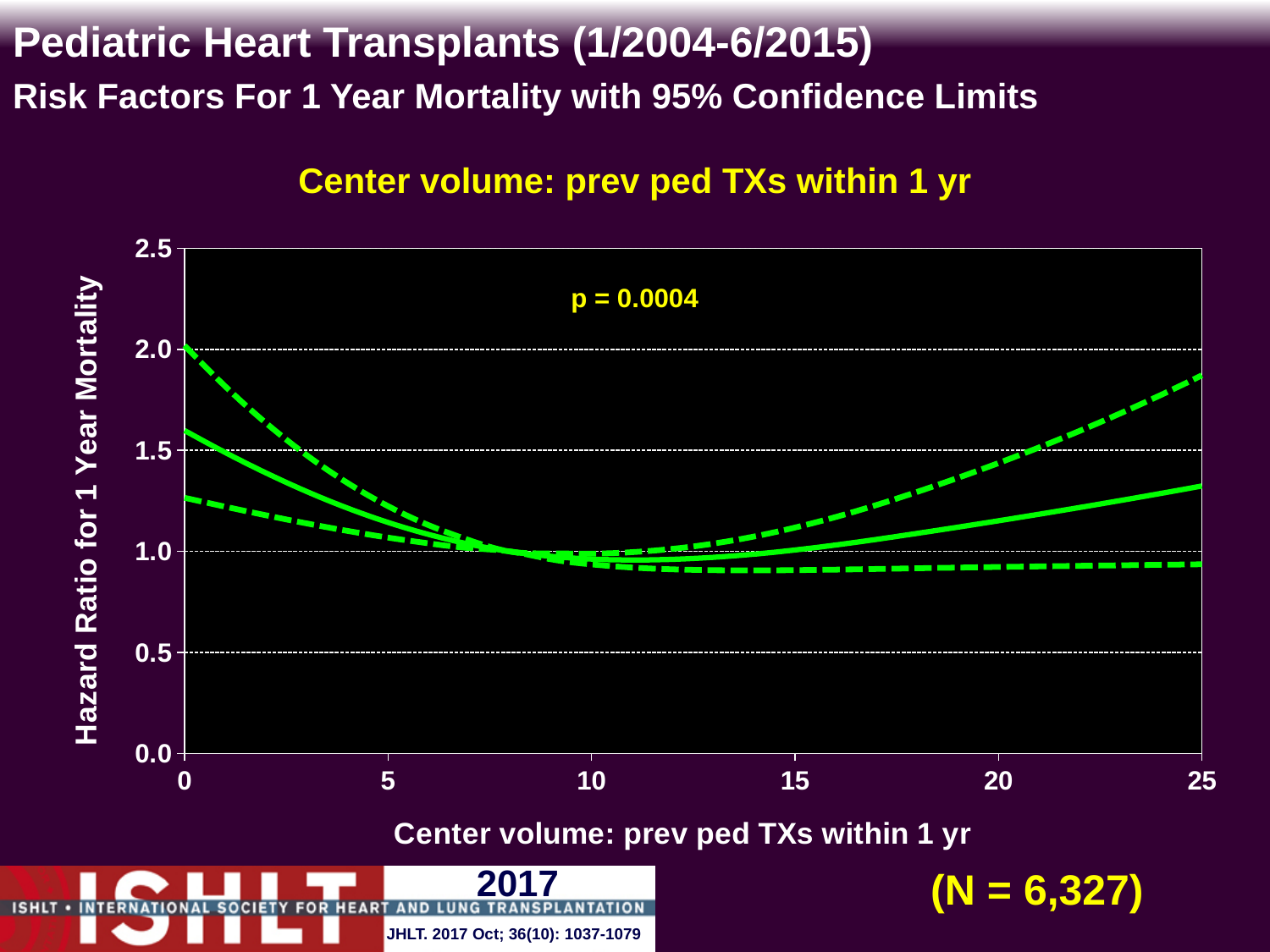
What kind of chart is shown on the slide? line chart What is the p-value printed on the chart? p = 0.0004 Is the hazard ratio (solid line) at a center volume of 0 greater or less than 1.5? greater Does the hazard ratio (solid line) rise or fall as center volume increases from 15 to 25? rise Is the hazard ratio (solid line) at a center volume of 25 greater or less than 1.0? greater How many lines are plotted on the chart? 3 Is the lower confidence limit (lower dashed line) at a center volume of 25 greater or less than 1.0? less Is the hazard ratio (solid line) at a center volume of 0 larger or smaller than at a center volume of 25? larger What is the sample size (N) shown on the slide? N = 6,327 Does the hazard ratio (solid line) rise or fall as center volume increases from 0 to 10? fall